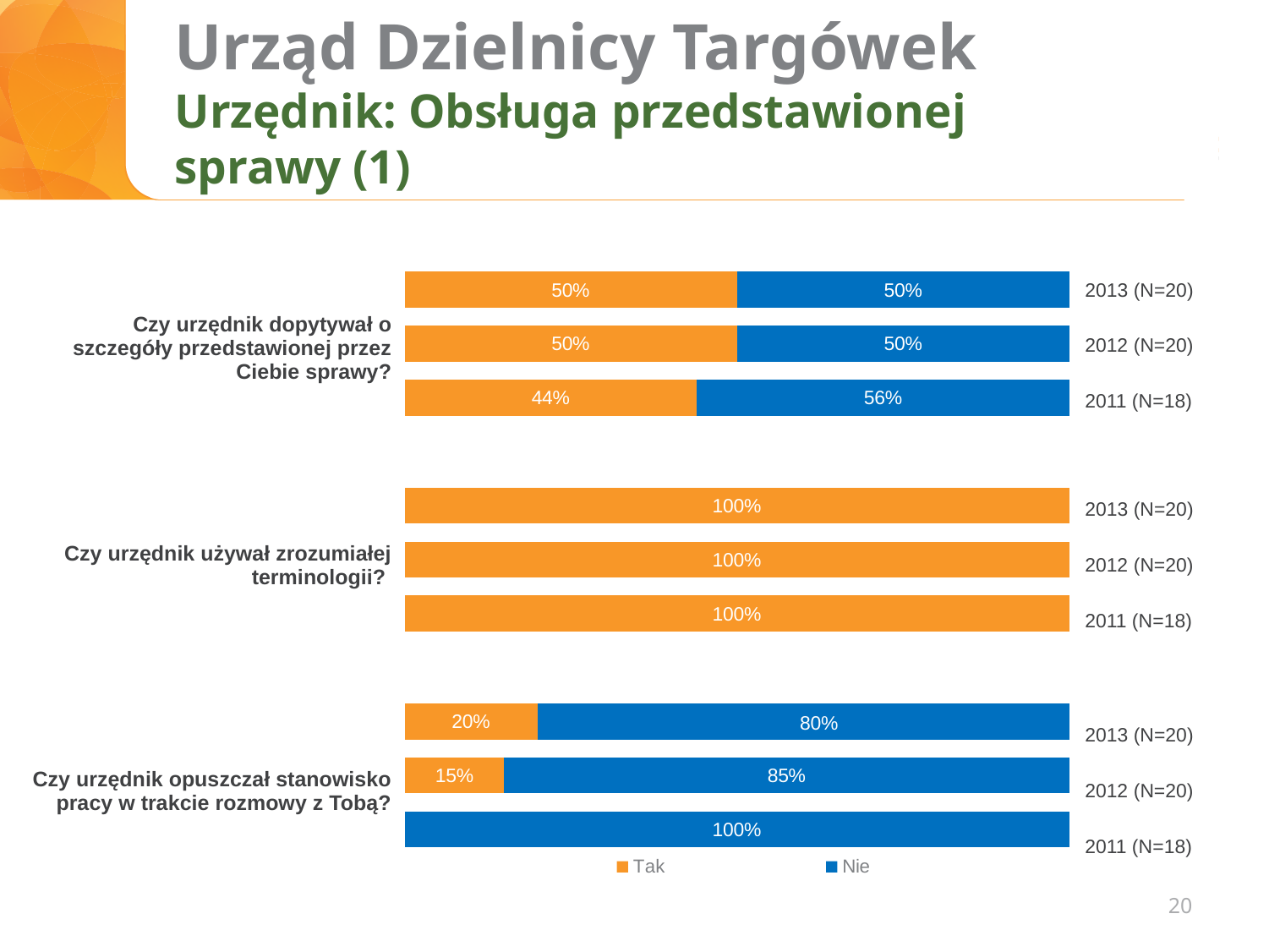
In the chart for "Czy urzędnik opuszczał stanowisko pracy w trakcie rozmowy z Tobą?", what is the "Nie" value for 2012 (N=20)? 85% In the chart for "Czy urzędnik opuszczał stanowisko pracy w trakcie rozmowy z Tobą?", does the "Tak" value rise or fall from 2011 to 2013? Rise What kind of chart is used on the slide? Stacked bar chart In the chart for "Czy urzędnik opuszczał stanowisko pracy w trakcie rozmowy z Tobą?", which year has the highest "Tak" value? 2013 (N=20) In the chart for "Czy urzędnik dopytywał o szczegóły przedstawionej przez Ciebie sprawy?", what is the difference between the "Nie" and "Tak" values for 2011 (N=18)? 12% In the chart for "Czy urzędnik dopytywał o szczegóły przedstawionej przez Ciebie sprawy?", what is the "Nie" value for 2013 (N=20)? 50% In the chart for "Czy urzędnik dopytywał o szczegóły przedstawionej przez Ciebie sprawy?", which year has the lowest "Tak" value? 2011 (N=18) In the chart for "Czy urzędnik opuszczał stanowisko pracy w trakcie rozmowy z Tobą?", what is the "Tak" value for 2013 (N=20)? 20% In the chart for "Czy urzędnik dopytywał o szczegóły przedstawionej przez Ciebie sprawy?", what is the "Tak" value for 2011 (N=18)? 44% How many series does the legend at the bottom of the slide list? 2 In the chart for "Czy urzędnik używał zrozumiałej terminologii?", what is the "Tak" value for 2012 (N=20)? 100% In the chart for "Czy urzędnik opuszczał stanowisko pracy w trakcie rozmowy z Tobą?", is the "Nie" value larger for 2013 (N=20) or 2012 (N=20)? 2012 (N=20)